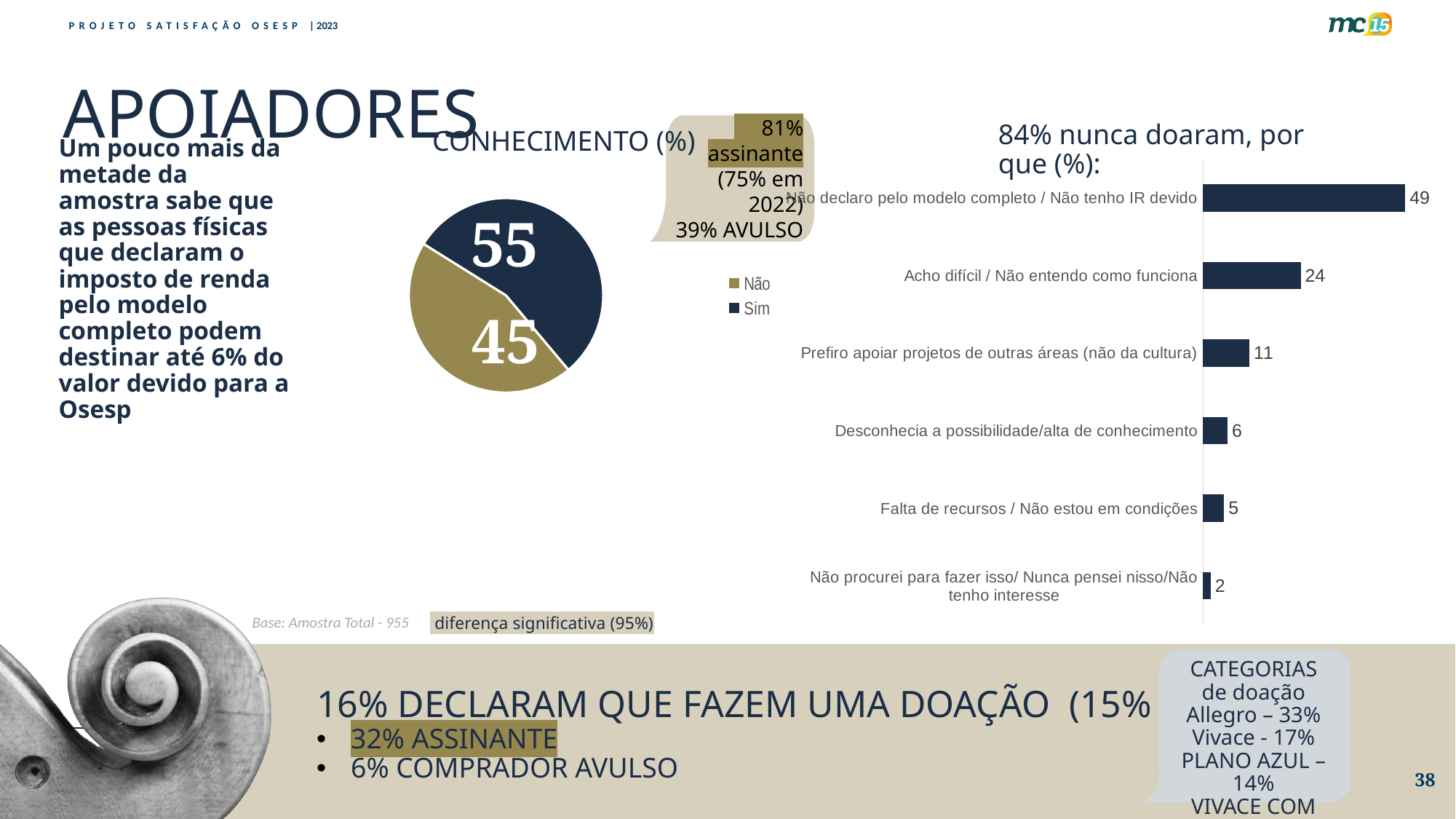
In the pie chart titled CONHECIMENTO (%), what is the value for Não? 45 In the pie chart titled CONHECIMENTO (%), which slice is larger, Sim or Não? Sim In the pie chart titled CONHECIMENTO (%), what is the value for Sim? 55 How many categories are shown in the bar chart titled '84% nunca doaram, por que (%):'? 6 In the bar chart titled '84% nunca doaram, por que (%):', what is the difference between the values for 'Não declaro pelo modelo completo / Não tenho IR devido' and 'Acho difícil / Não entendo como funciona'? 25 What kind of chart is the one titled '84% nunca doaram, por que (%):'? Bar chart In the pie chart titled CONHECIMENTO (%), how many entries does the legend list? 2 In the bar chart titled '84% nunca doaram, por que (%):', what is the value for 'Acho difícil / Não entendo como funciona'? 24 In the bar chart titled '84% nunca doaram, por que (%):', which category has the highest value? Não declaro pelo modelo completo / Não tenho IR devido In the bar chart titled '84% nunca doaram, por que (%):', which category has the lowest value? Não procurei para fazer isso/ Nunca pensei nisso/Não tenho interesse What kind of chart is the one titled CONHECIMENTO (%)? Pie chart In the bar chart titled '84% nunca doaram, por que (%):', what is the value for 'Falta de recursos / Não estou em condições'? 5